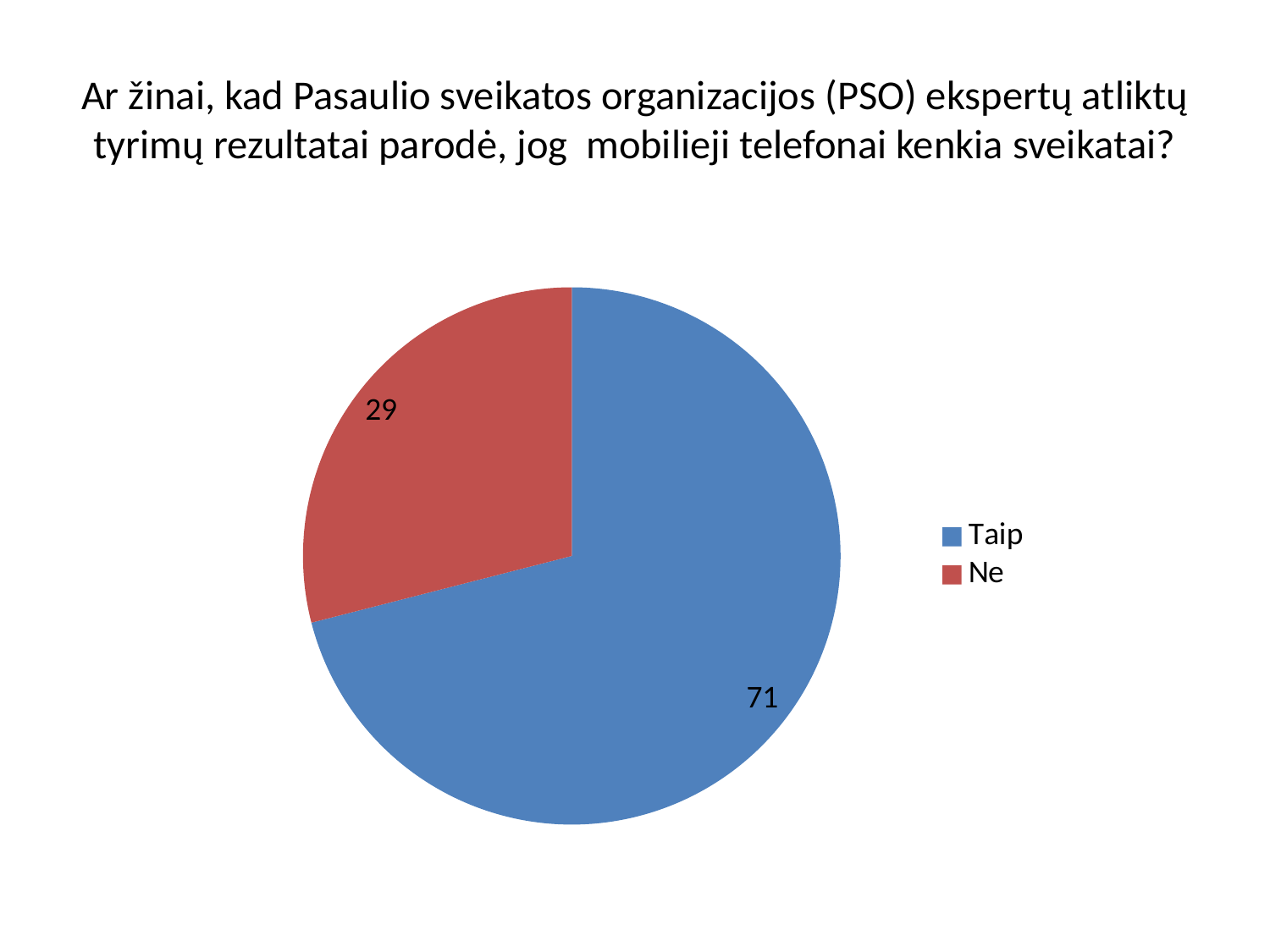
What is the difference between the values for Taip and Ne? 42 Which is larger, the value for Taip or the value for Ne? Taip How many slices does the pie chart have? 2 What is the value for Ne? 29 What is the total of the two slice values? 100 Which category has the largest slice? Taip How many entries does the legend list? 2 What colour is the Taip slice? blue What is the value for Taip? 71 Which category has the smallest slice? Ne What type of chart is shown on the slide? pie chart What share of the pie does the Ne slice represent? 29%